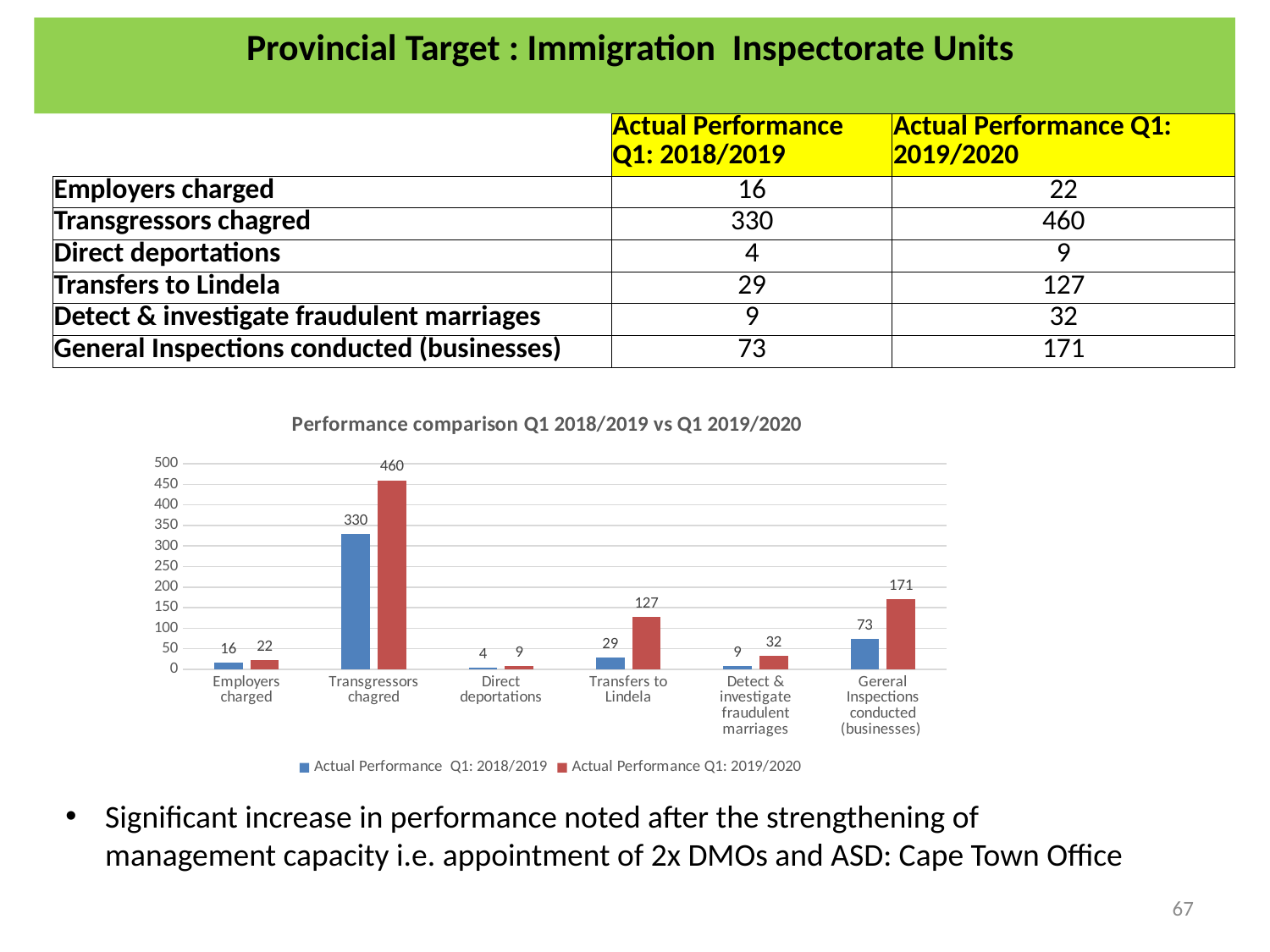
What is the Actual Performance Q1: 2018/2019 value for General Inspections conducted (businesses)? 73 How many series does the chart legend list? 2 What is the title of the chart? Performance comparison Q1 2018/2019 vs Q1 2019/2020 Which is larger for Detect & investigate fraudulent marriages: the Q1 2018/2019 value or the Q1 2019/2020 value? Q1 2019/2020 Is the Actual Performance Q1: 2019/2020 value for General Inspections conducted (businesses) greater or less than 150? greater What kind of chart is shown on the slide? bar chart Which category has the lowest Actual Performance Q1: 2018/2019 value? Direct deportations What is the Actual Performance Q1: 2019/2020 value for Transfers to Lindela? 127 Which category has the highest Actual Performance Q1: 2019/2020 value? Transgressors chagred What is the difference between the Q1 2019/2020 and Q1 2018/2019 values for Transfers to Lindela? 98 What is the difference between the Q1 2019/2020 and Q1 2018/2019 values for Transgressors chagred? 130 How many categories are shown on the x axis of the chart? 6